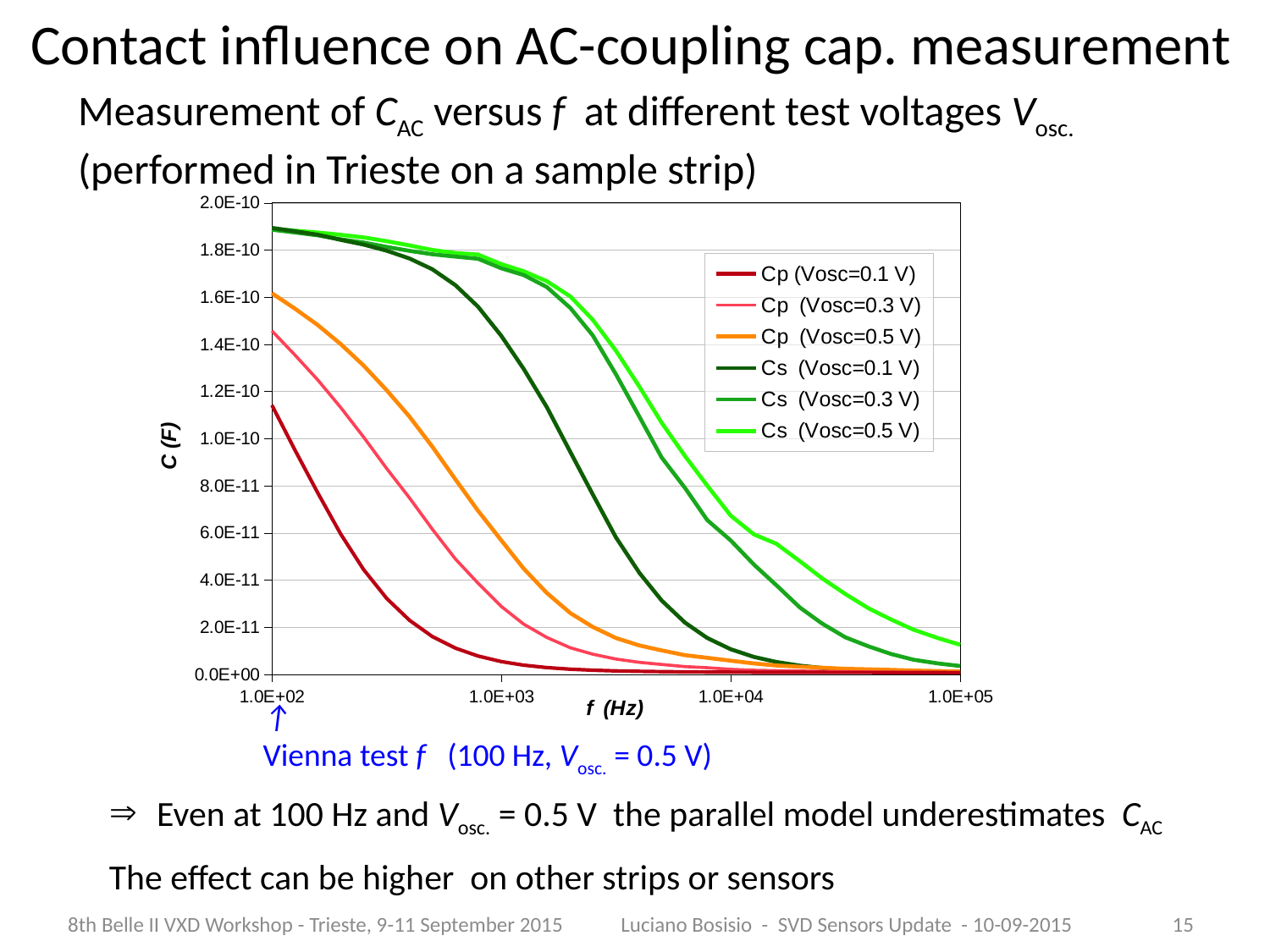
Is the value of Cs (Vosc=0.5 V) at 1.0E+02 Hz greater or less than 1.8E-10? greater What is the label of the y axis? C (F) What is the label of the x axis? f (Hz) At 1.0E+02 Hz, which is larger: Cs (Vosc=0.1 V) or Cp (Vosc=0.1 V)? Cs (Vosc=0.1 V) What kind of chart is shown on the slide? line chart At 1.0E+03 Hz, which is larger: Cp (Vosc=0.1 V) or Cp (Vosc=0.5 V)? Cp (Vosc=0.5 V) How many series does the legend list? 6 Is the value of Cp (Vosc=0.3 V) at 1.0E+02 Hz greater or less than 1.2E-10? greater Is the value of Cp (Vosc=0.5 V) at 1.0E+02 Hz greater or less than 1.4E-10? greater Which series has the lowest value at 1.0E+03 Hz? Cp (Vosc=0.1 V) Do the capacitance values rise or fall as the frequency f increases along the x axis? fall